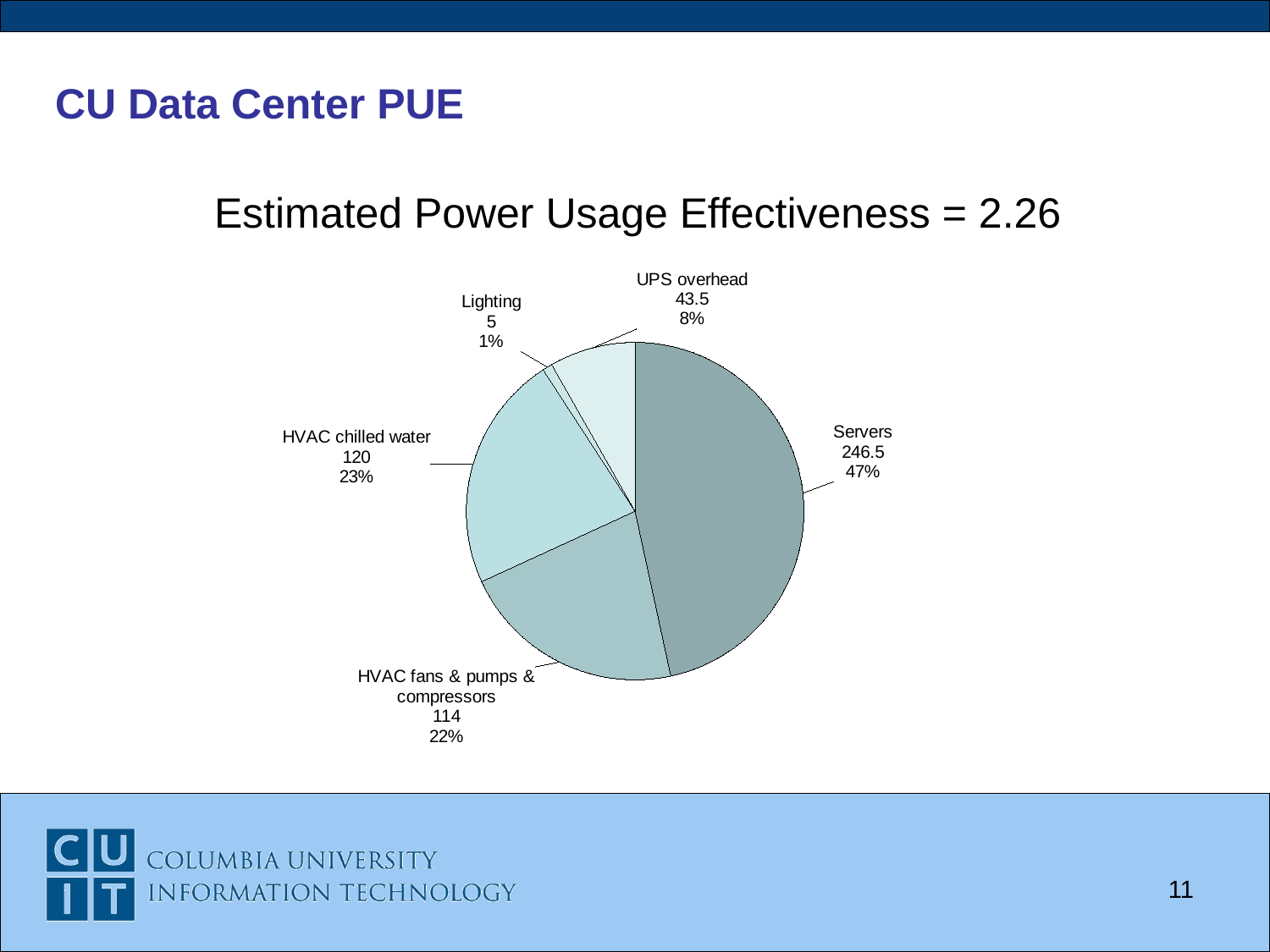
What is the value for HVAC chilled water? 120 What is the estimated Power Usage Effectiveness stated on the slide? 2.26 What kind of chart is shown on the slide? pie chart What is the value for UPS overhead? 43.5 Which category has the smallest slice? Lighting What is the difference between the values for Servers and HVAC chilled water? 126.5 What is the value for Servers? 246.5 What share of the pie does Lighting represent? 1% How many slices does the pie chart have? 5 What share of the pie does HVAC fans & pumps & compressors represent? 22% Which is larger, the value for UPS overhead or the value for Lighting? UPS overhead Which category has the largest slice? Servers